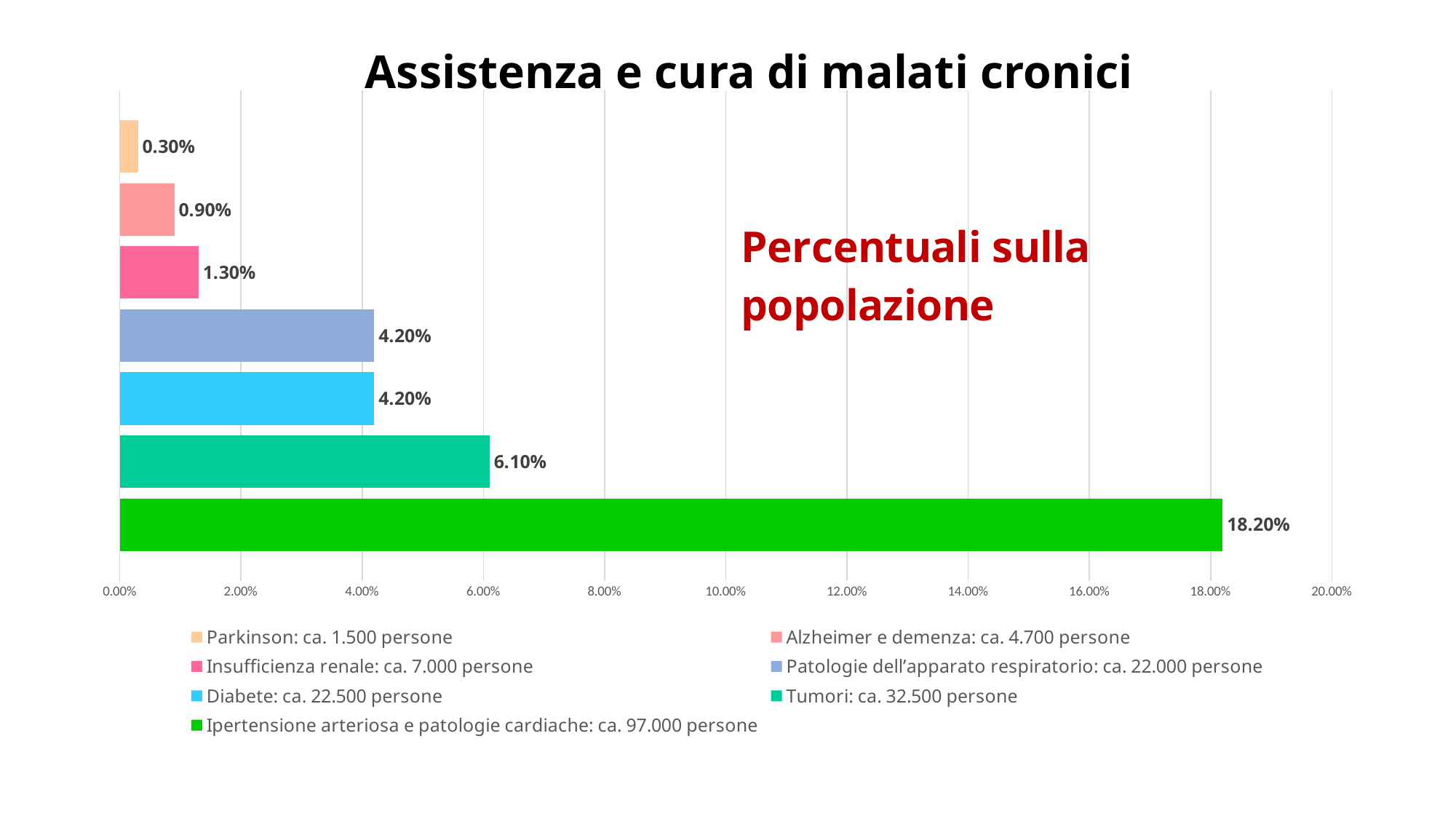
What is the value for Alzheimer e demenza? 0.90% What type of chart is shown on the slide? bar chart What is the title of the chart? Assistenza e cura di malati cronici What is the difference between the values for Ipertensione arteriosa e patologie cardiache and Tumori? 12.10% How many bars are plotted in the chart? 7 How many entries does the legend list? 7 What is the value for Ipertensione arteriosa e patologie cardiache? 18.20% What is the value for Parkinson? 0.30% Which category has the lowest value? Parkinson Which is larger, the value for Insufficienza renale or the value for Alzheimer e demenza? Insufficienza renale What is the value for Tumori? 6.10% Which category has the highest value? Ipertensione arteriosa e patologie cardiache